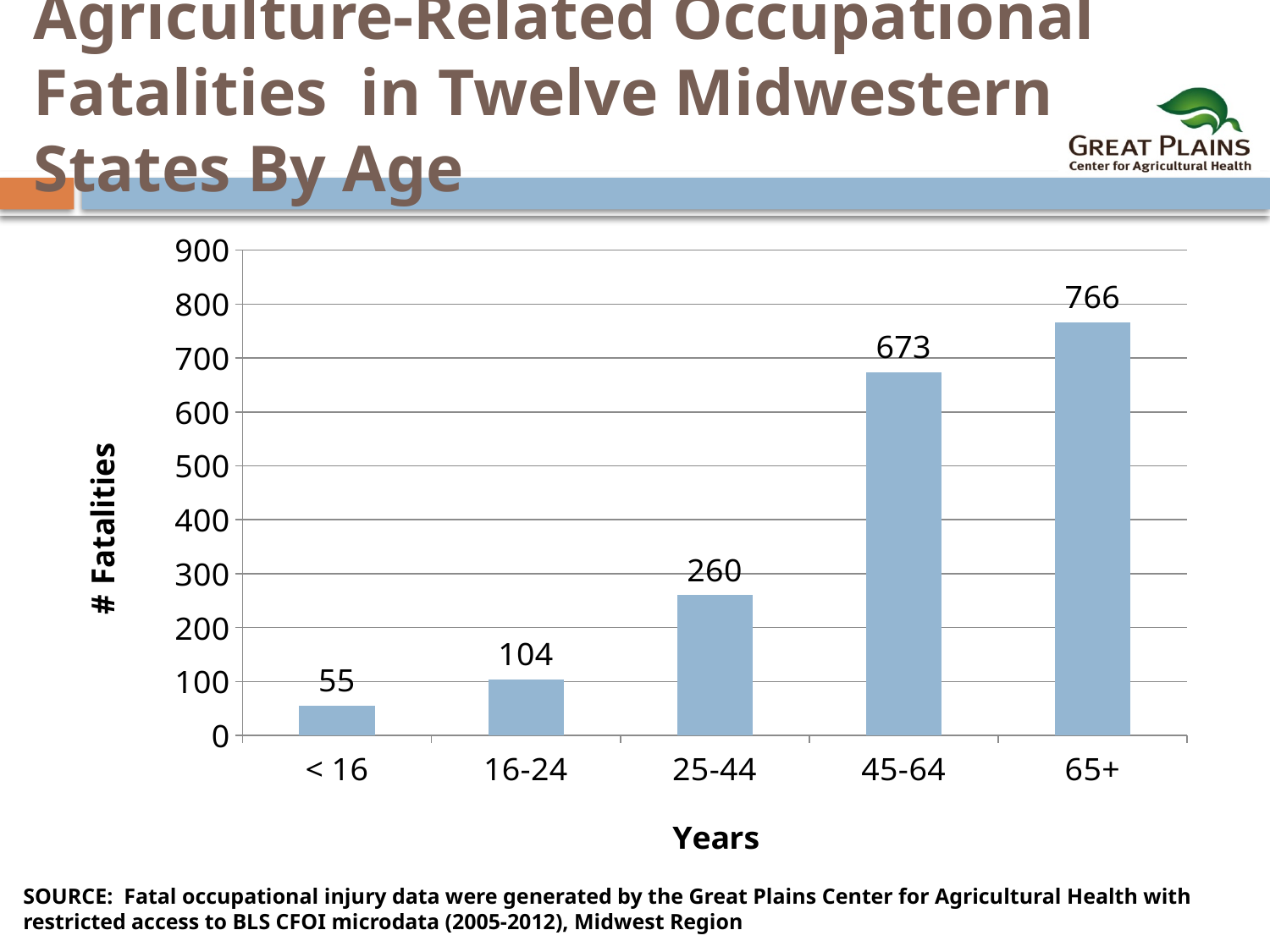
What is the difference in fatalities between the 25-44 and 16-24 age groups? 156 Which age group has the lowest number of fatalities? < 16 Which age group has the highest number of fatalities? 65+ Which age group has more fatalities, 16-24 or 25-44? 25-44 What is the difference in fatalities between the 65+ and 45-64 age groups? 93 What is the value for the 25-44 age group? 260 What kind of chart is shown on the slide? Bar chart How many age groups are shown on the x axis? 5 How many fatalities are shown for the 45-64 age group? 673 What is the number of fatalities for the < 16 age group? 55 Is the value for the 45-64 age group greater or less than 600? greater Do the fatality counts rise or fall as age increases along the x axis? Rise